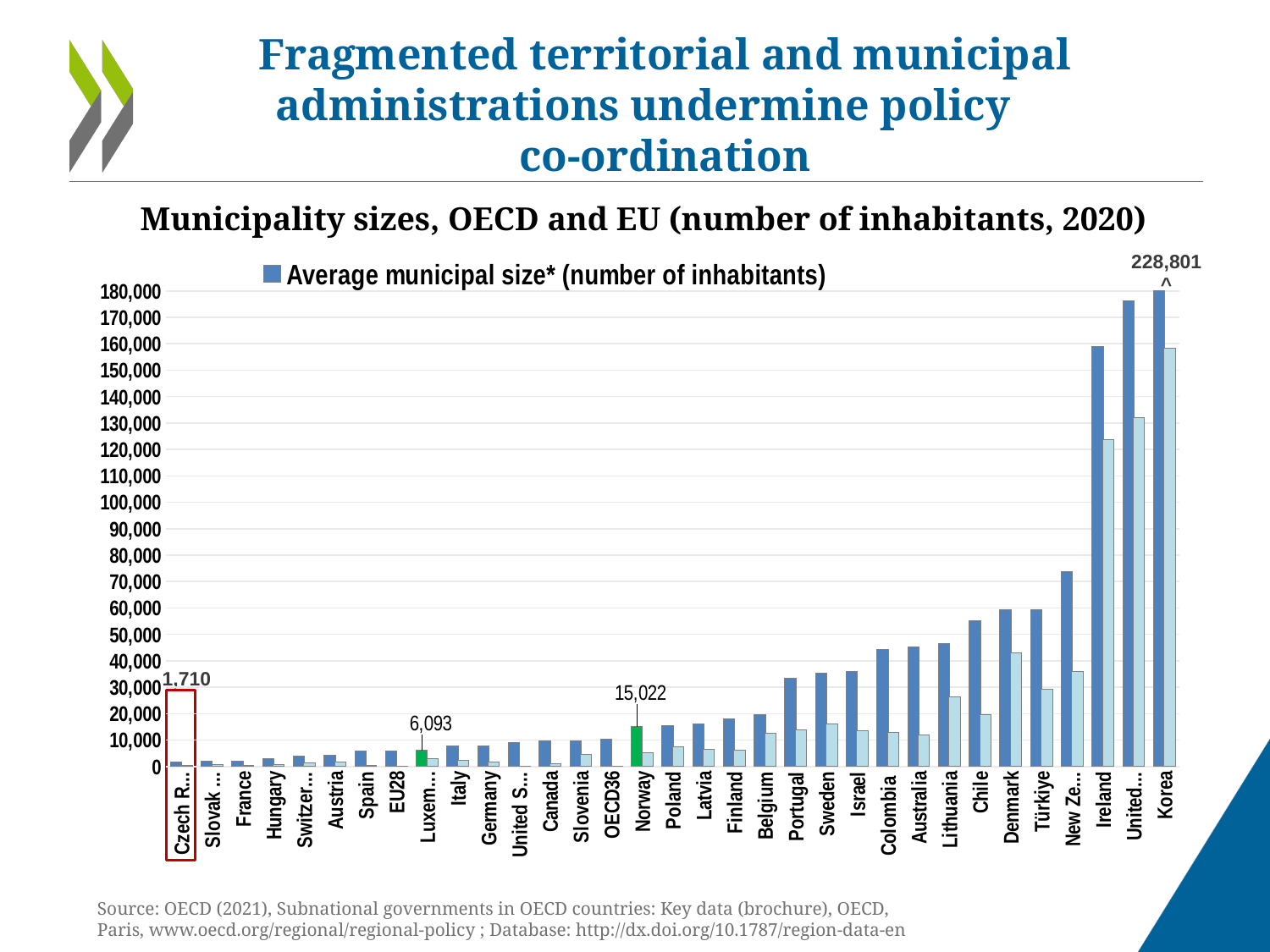
What is the difference between the average municipal size of Norway and Luxembourg? 8,929 What is the average municipal size for the Czech Republic? 1,710 Is the average municipal size for Ireland greater or less than 150,000? greater Which country has the highest average municipal size? Korea Is the average municipal size for Portugal greater or less than 40,000? less What is the average municipal size for Korea? 228,801 What is the average municipal size for Norway? 15,022 Which country has the lowest average municipal size? Czech Republic What is the average municipal size for Luxembourg? 6,093 Which has a larger average municipal size, Ireland or Denmark? Ireland What kind of chart is shown on the slide? bar chart Do the average municipal size values rise or fall from left to right along the x axis? rise